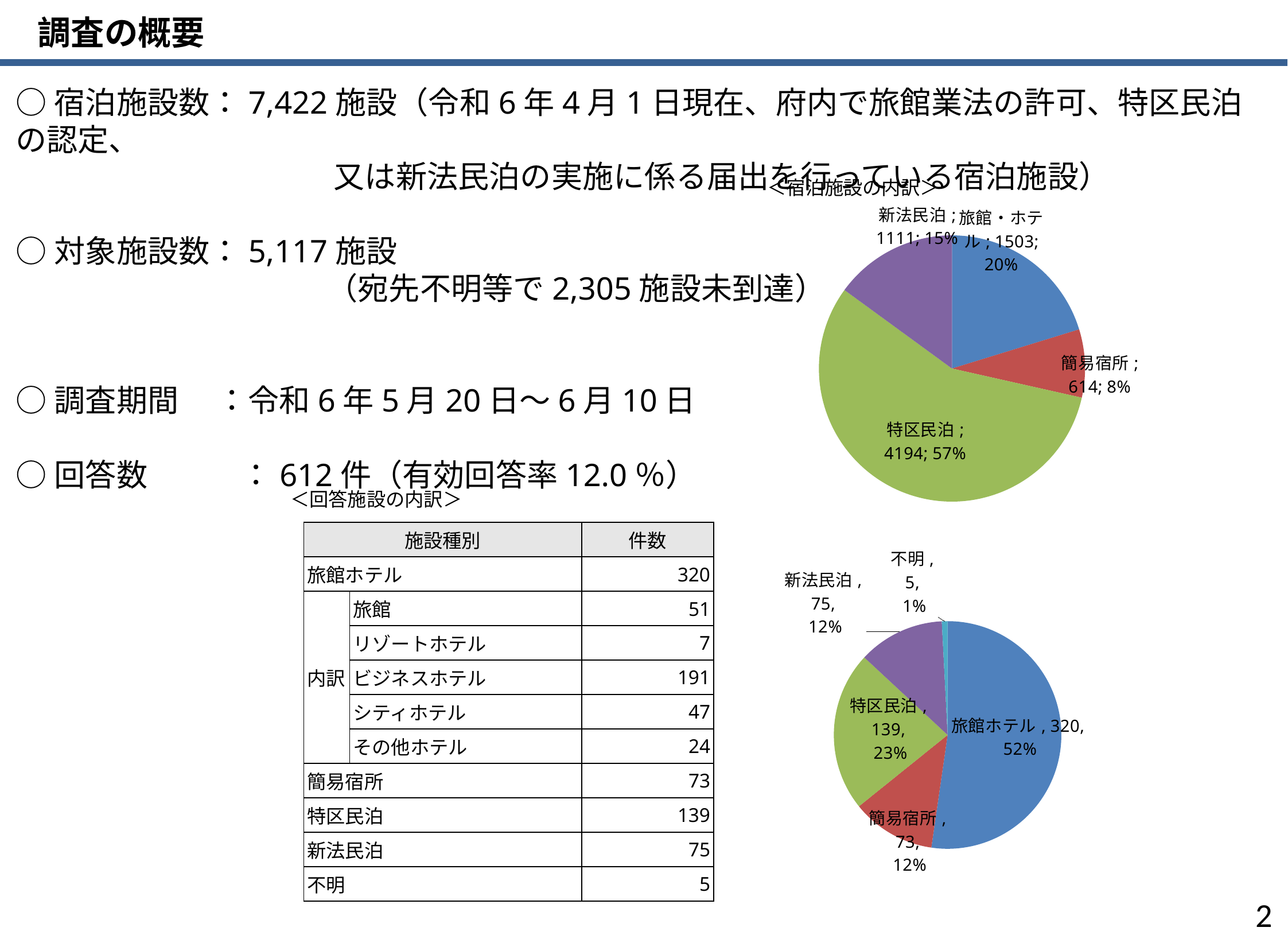
In the bottom pie chart, how many categories are shown? 5 In the bottom pie chart, what is the value for 特区民泊? 139 What type of chart is the bottom chart on the right side of the slide? Pie chart In the top pie chart (宿泊施設の内訳), how many categories are shown? 4 In the bottom pie chart, what percentage share does 旅館ホテル have? 52% In the bottom pie chart, which is larger, the value for 簡易宿所 or the value for 特区民泊? 特区民泊 In the top pie chart (宿泊施設の内訳), what is the difference between the values for 旅館・ホテル and 新法民泊? 392 In the top pie chart (宿泊施設の内訳), what percentage share does 旅館・ホテル have? 20% In the top pie chart (宿泊施設の内訳), which category has the smallest slice? 簡易宿所 In the top pie chart (宿泊施設の内訳), what is the value for 特区民泊? 4194 In the bottom pie chart, which category has the smallest slice? 不明 In the top pie chart (宿泊施設の内訳), which category has the largest slice? 特区民泊